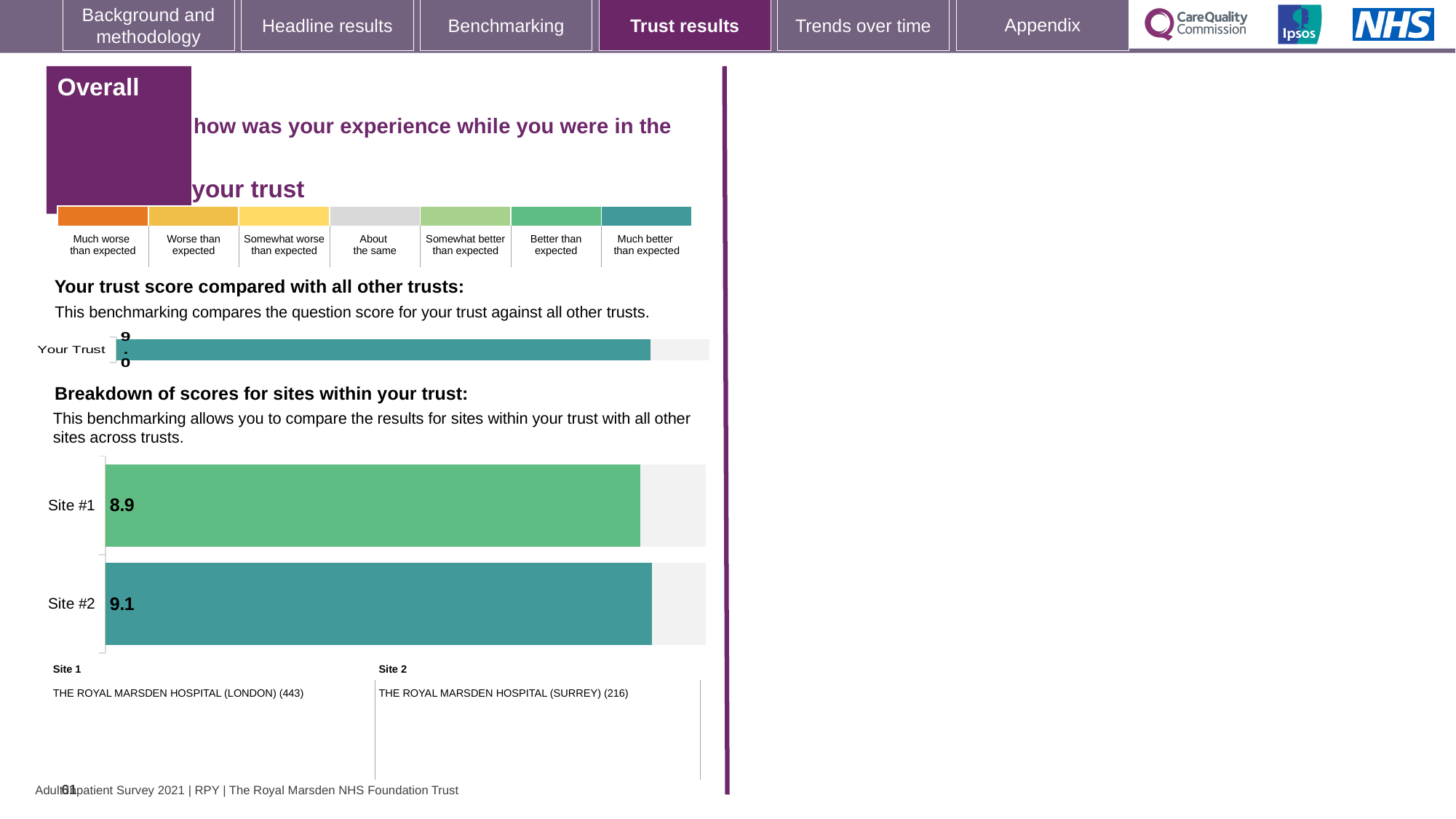
What kind of chart is the 'Breakdown of scores for sites within your trust' chart? bar chart In the 'Breakdown of scores for sites within your trust' chart, what is the score for Site #1? 8.9 How many sites are shown in the 'Breakdown of scores for sites within your trust' chart? 2 In the 'Breakdown of scores for sites within your trust' chart, is the score for Site #1 larger or smaller than the score for Site #2? smaller How many bars are shown in the 'Your trust score compared with all other trusts' chart? 1 In the 'Breakdown of scores for sites within your trust' chart, which site has the higher score? Site #2 In the 'Breakdown of scores for sites within your trust' chart, what is the difference between the scores for Site #2 and Site #1? 0.2 In the 'Breakdown of scores for sites within your trust' chart, what is the score for Site #2? 9.1 In the 'Breakdown of scores for sites within your trust' chart, which site has the lower score? Site #1 In the 'Breakdown of scores for sites within your trust' chart, what colour is the bar for Site #2? teal In the 'Your trust score compared with all other trusts' chart, what is the score shown for Your Trust? 9.0 According to the site key below the 'Breakdown of scores for sites within your trust' chart, which hospital is Site 1? THE ROYAL MARSDEN HOSPITAL (LONDON) (443)